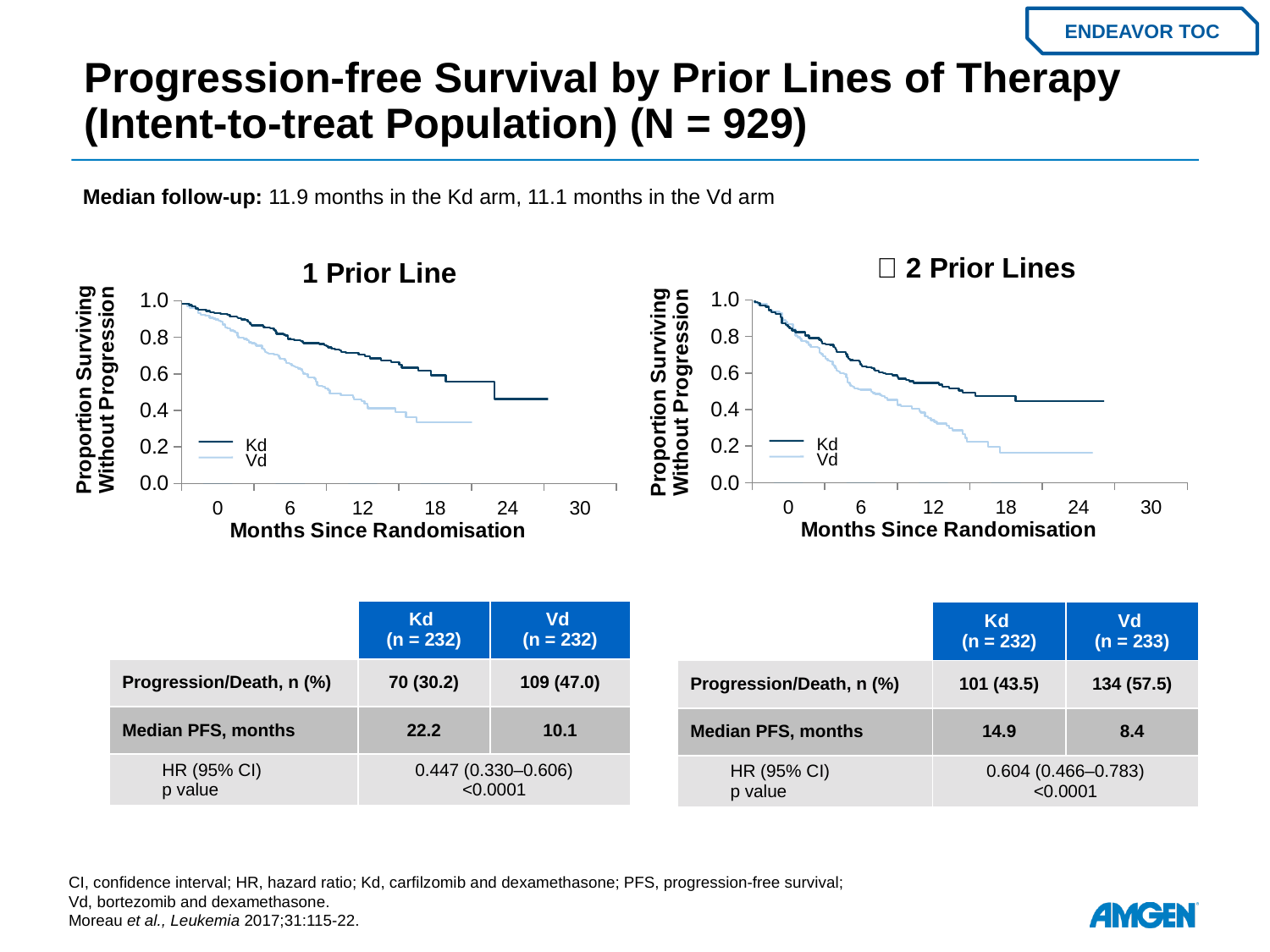
In the '1 Prior Line' chart, which series is higher at 12 months, Kd or Vd? Kd In the '1 Prior Line' chart, is the Kd value at 12 months greater or less than 0.6? greater In the right-hand chart (2 Prior Lines), is the Vd value at 18 months greater or less than 0.4? less In the '1 Prior Line' chart, is the Vd value at 12 months greater or less than 0.6? less In the right-hand chart (2 Prior Lines), does the Vd curve rise or fall along the x axis? fall How many series does the legend of the '1 Prior Line' chart list? 2 In the '1 Prior Line' chart, do the Kd and Vd curves rise or fall as months since randomisation increase? fall What kind of chart is the '1 Prior Line' chart on the left? line chart In the right-hand chart (2 Prior Lines), which series is higher at 18 months, Kd or Vd? Kd What is the x-axis label of the '1 Prior Line' chart? Months Since Randomisation What are the two series named in the legend of the right-hand chart? Kd and Vd